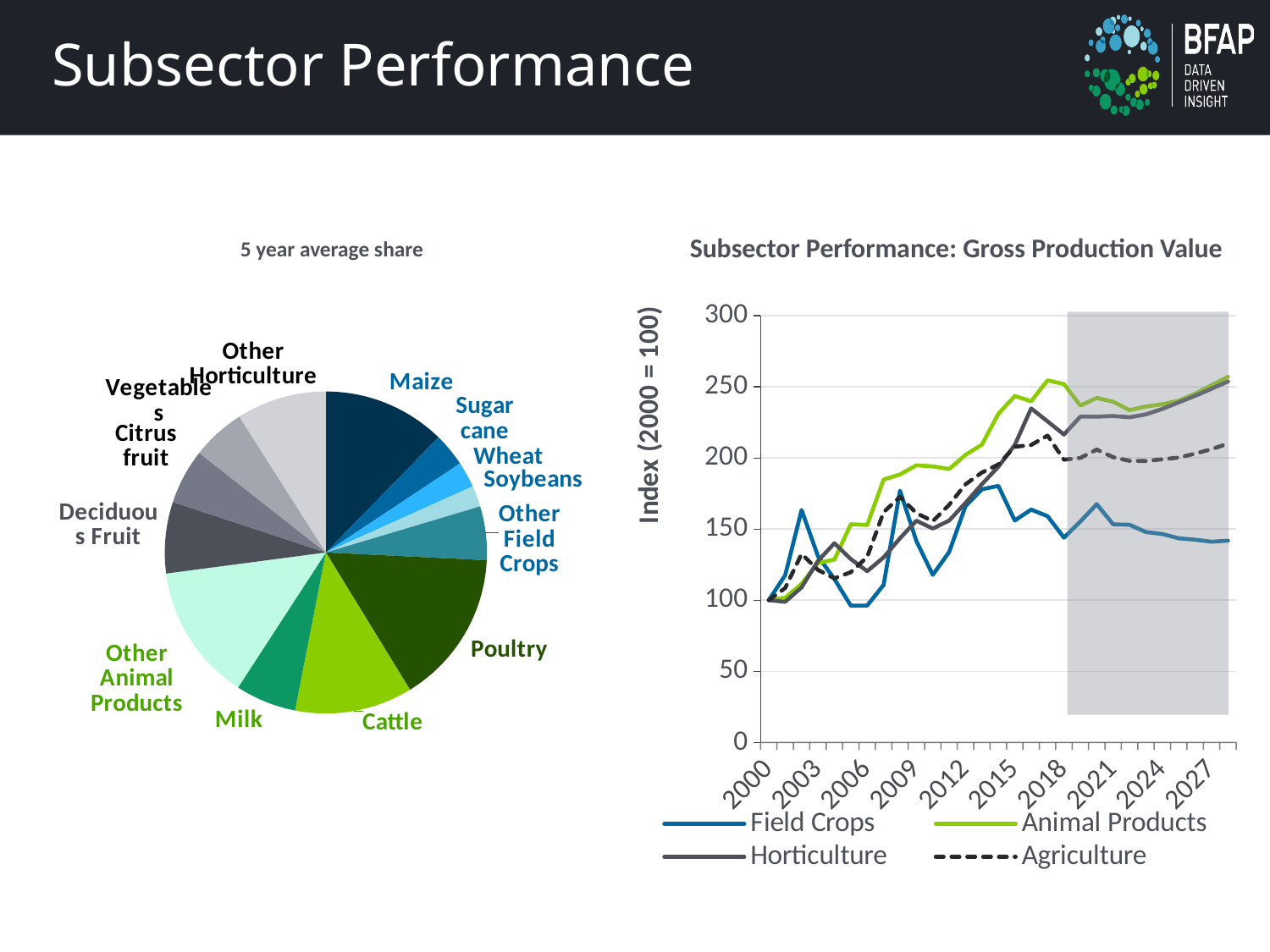
In 'Subsector Performance: Gross Production Value', is the Agriculture value in 2027 greater or less than 200? greater What kind of chart is the '5 year average share' chart on the left? Pie chart How many slices does the '5 year average share' pie chart have? 13 What kind of chart is 'Subsector Performance: Gross Production Value'? Line chart In 'Subsector Performance: Gross Production Value', what is the index value of every series in 2000? 100 In 'Subsector Performance: Gross Production Value', is the Field Crops value in 2027 greater or less than 150? less In 'Subsector Performance: Gross Production Value', which series is drawn with a dashed line? Agriculture In 'Subsector Performance: Gross Production Value', which series has the lowest value in 2027? Field Crops In 'Subsector Performance: Gross Production Value', does the Field Crops series rise or fall between 2021 and 2027? Fall How many series does the legend of 'Subsector Performance: Gross Production Value' list? 4 In 'Subsector Performance: Gross Production Value', which is larger in 2027: Animal Products or Field Crops? Animal Products